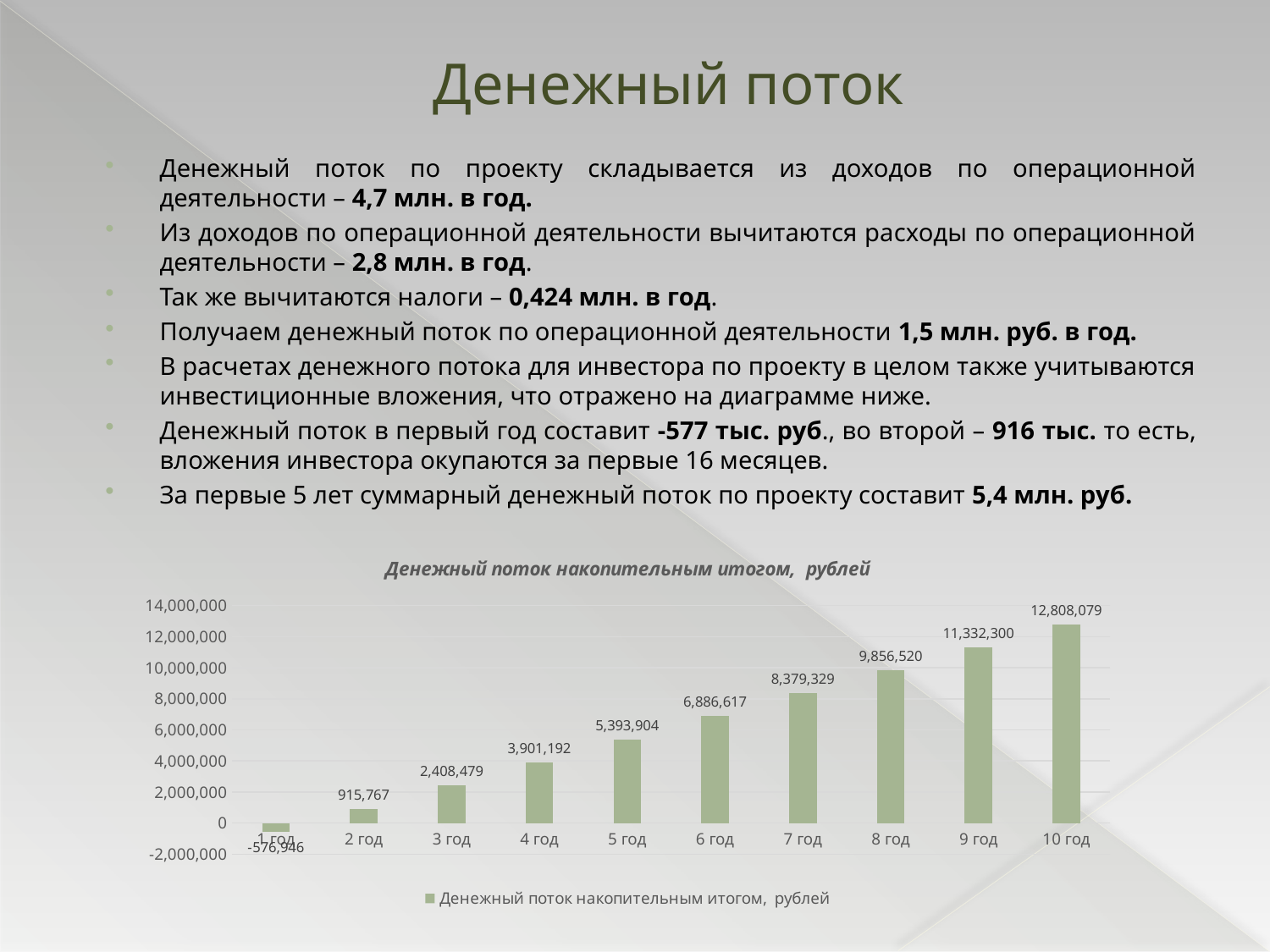
What value is labelled on the bar for 1 год? -576,946 How many years (categories) are shown on the x axis? 10 Which year has the highest cumulative cash flow? 10 год Which year has the lowest cumulative cash flow? 1 год What is the value shown for 8 год? 9,856,520 What is the difference between the values for 3 год and 2 год? 1,492,712 Do the values rise or fall from 1 год to 10 год? rise Which is larger, the value for 6 год or the value for 7 год? 7 год What is the cumulative cash flow value shown for 5 год? 5,393,904 What is the difference between the values for 10 год and 9 год? 1,475,779 Is the value for 9 год greater or less than 10,000,000? greater What type of chart is shown on the slide? bar chart